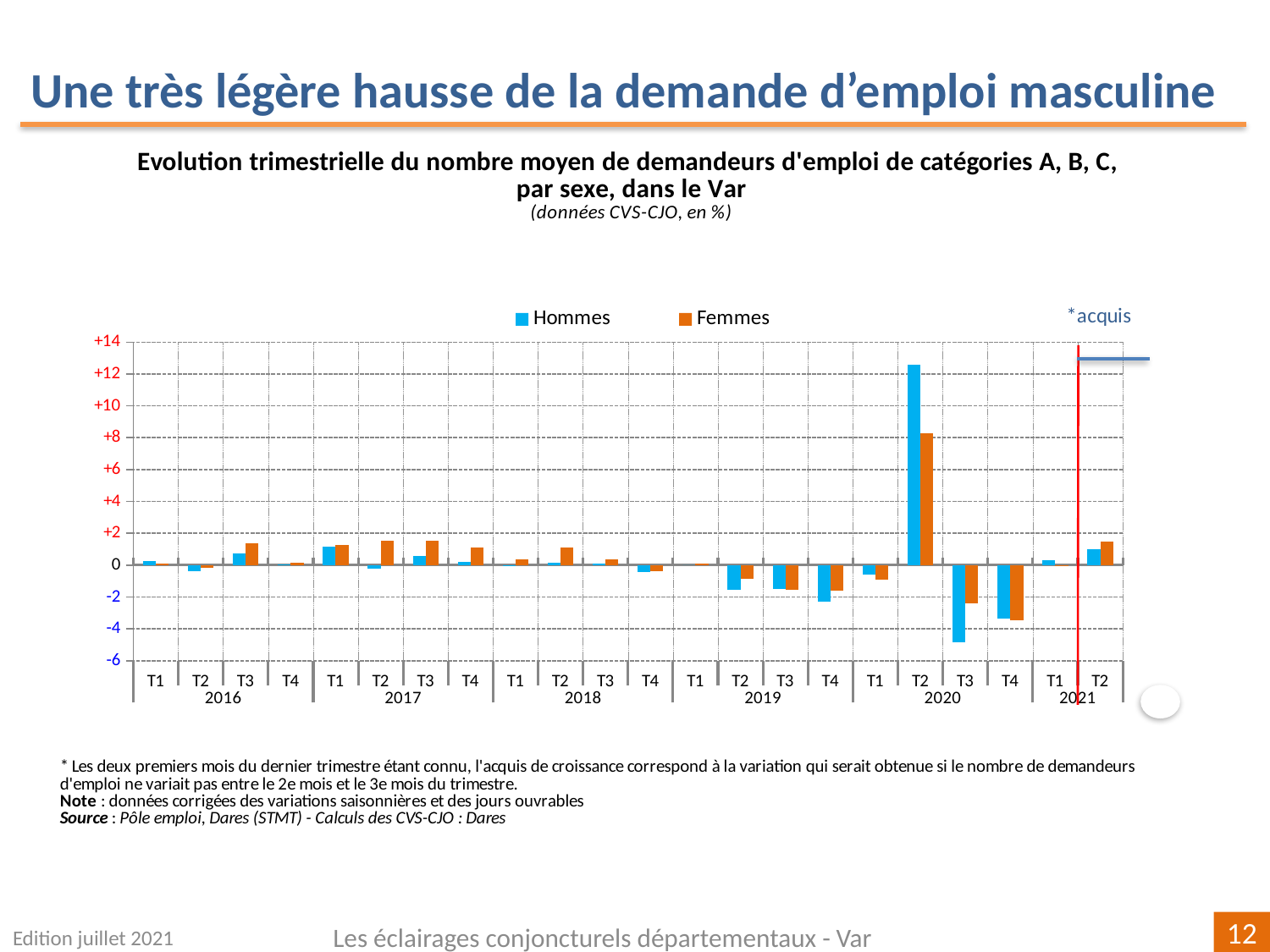
How many series does the legend list? 2 In which quarter does the Femmes series reach its highest value? T2 2020 Is the Femmes value for T2 2020 greater or less than +6? greater In which quarter does the Hommes series reach its lowest value? T3 2020 In which quarter does the Hommes series reach its highest value? T2 2020 What type of chart is shown on the slide? bar chart What are the two series named in the legend? Hommes and Femmes Is the Hommes value for T3 2020 greater or less than -4? less Is the Hommes value for T2 2020 greater or less than +10? greater How many quarters (T1–T4 periods) are plotted along the x axis? 22 In T2 2020, which series has the larger value, Hommes or Femmes? Hommes In T2 2017, which series has the larger value, Hommes or Femmes? Femmes